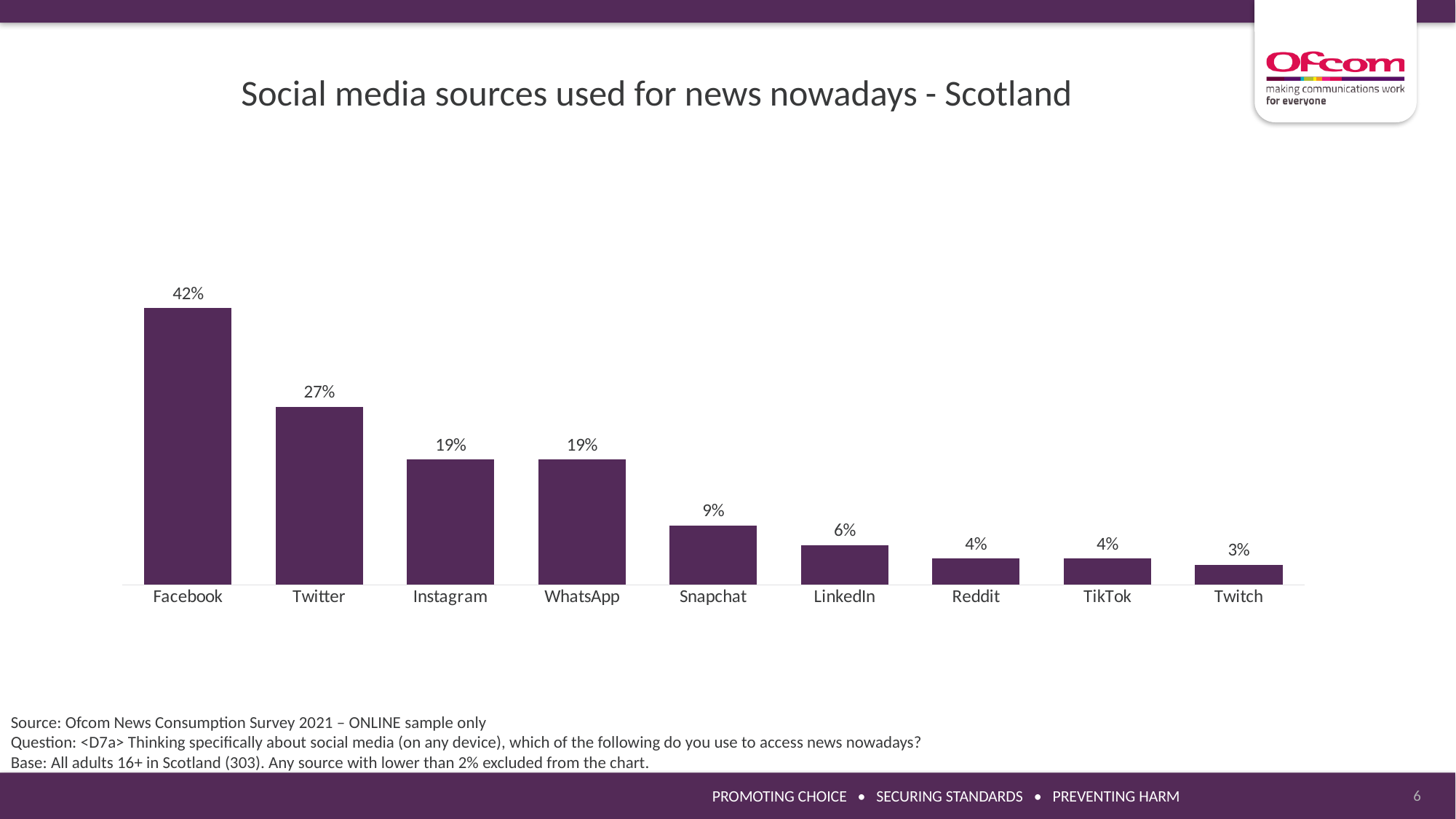
How many social media sources are shown on the chart? 9 Which social media source has the highest value on the chart? Facebook Which has a higher value, Instagram or Snapchat? Instagram What is the value shown for Snapchat? 9% What kind of chart is shown on the slide? Bar chart Which social media source has the lowest value on the chart? Twitch What is the value shown for LinkedIn? 6% What percentage of adults in Scotland use Facebook as a social media source for news? 42% What is the difference between the values for Twitter and Snapchat? 18% Do the values rise or fall moving from left to right across the chart? Fall Which has a higher value, LinkedIn or Twitch? LinkedIn What is the difference between the values for Facebook and Twitter? 15%